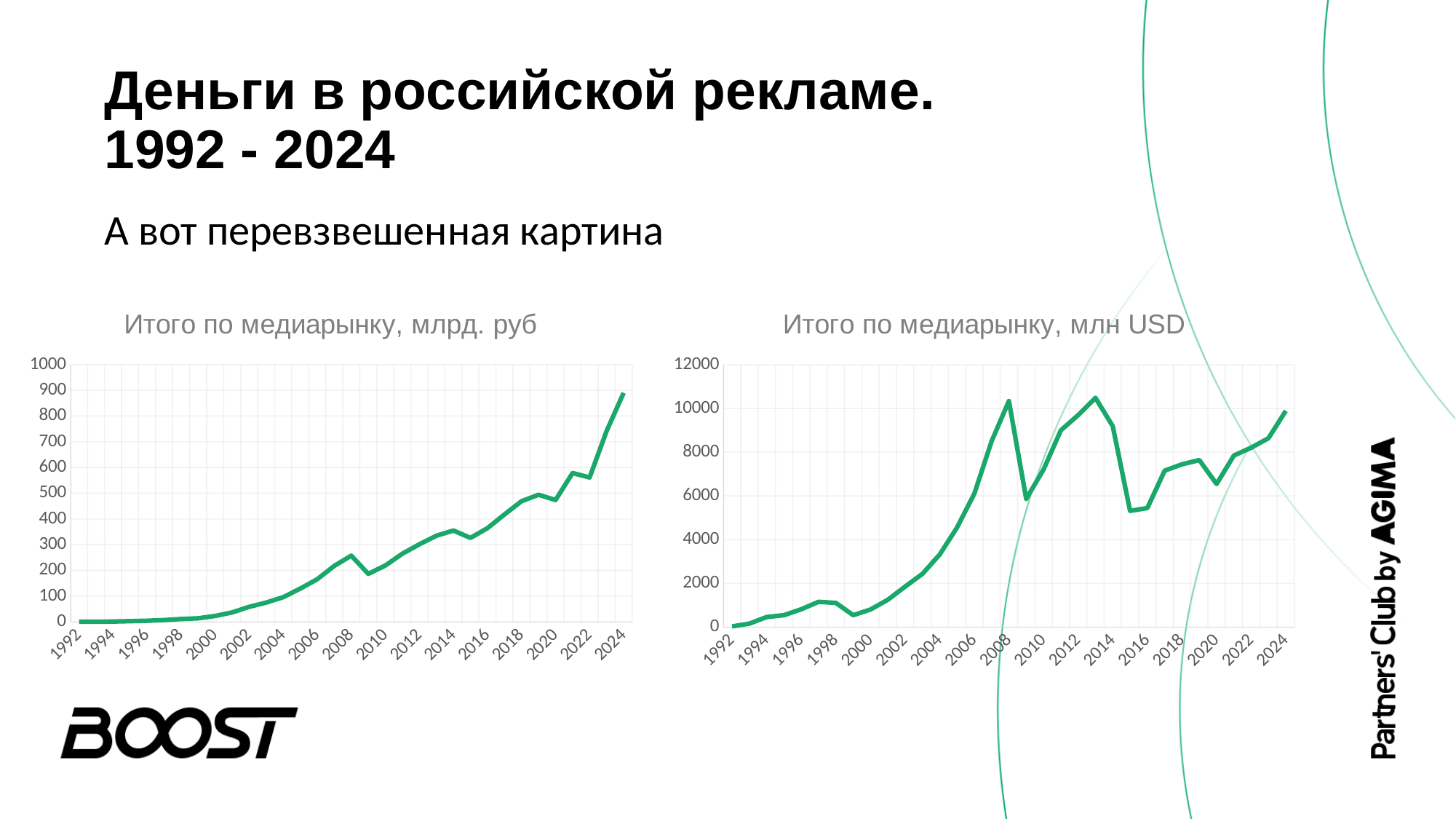
What kind of chart is the right chart titled "Итого по медиарынку, млн USD"? line chart In the right chart (млн USD), is the value for 2024 greater or less than 8000? greater What kind of chart is the left chart titled "Итого по медиарынку, млрд. руб"? line chart In the right chart (млн USD), is the value for 2015 greater or less than 6000? less How many charts are shown on the slide? 2 In the left chart (млрд. руб), which year has the highest value? 2024 In the right chart (млн USD), do the values rise or fall from 2013 to 2015? fall In the left chart (млрд. руб), which year has the lowest value? 1992 In the left chart (млрд. руб), which is larger, the value for 2008 or the value for 2009? 2008 In the left chart (млрд. руб), is the value for 2024 greater or less than 800? greater In the right chart (млн USD), which is larger, the value for 2013 or the value for 2015? 2013